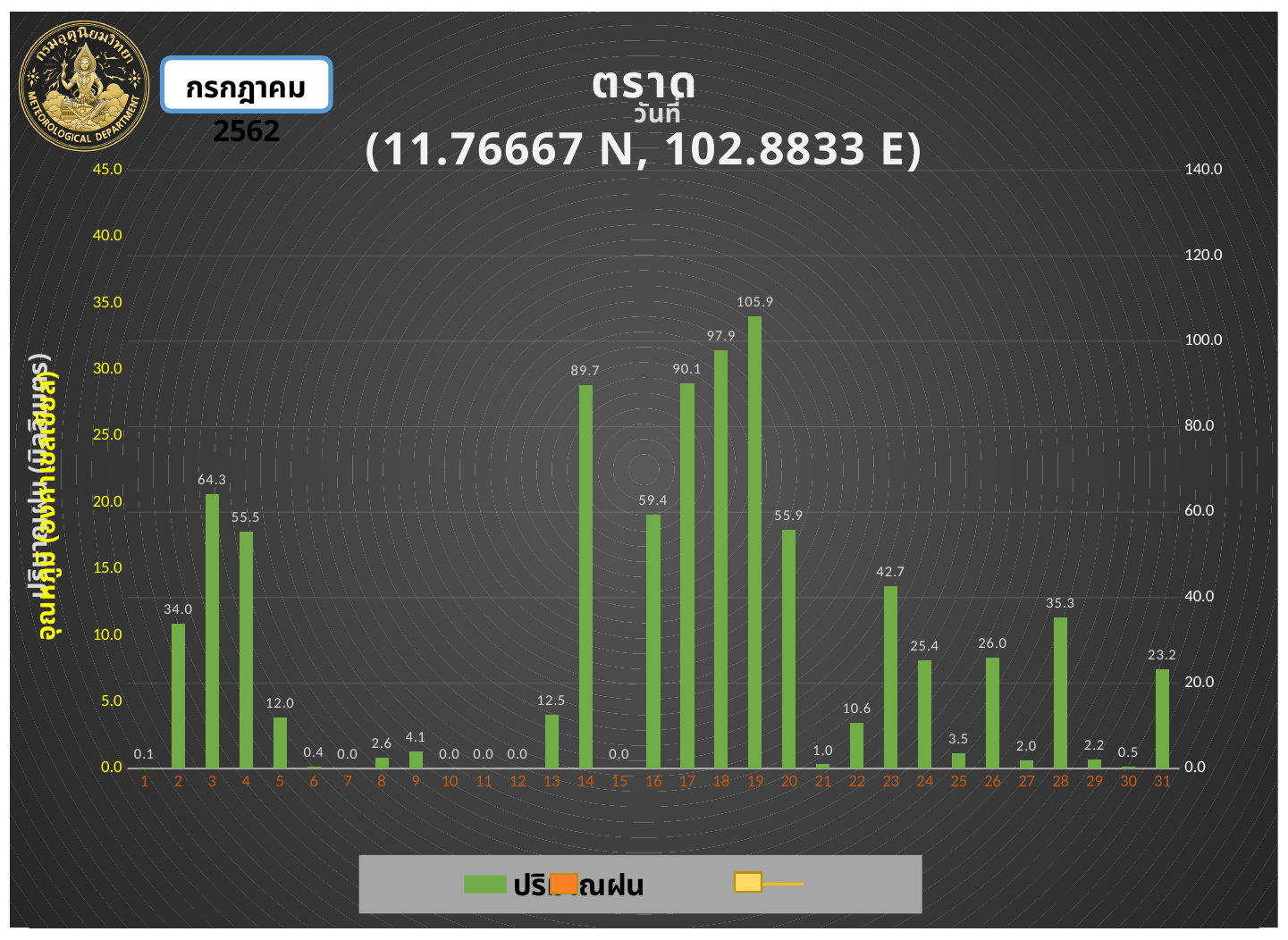
Which is larger, the value for day 14 or the value for day 16? day 14 How many days are shown along the x axis of the chart? 31 What type of chart is shown on the slide? bar chart What is the value labelled on the bar for day 3? 64.3 What is the value shown for day 23? 42.7 Which day has the highest bar in the chart? 19 What is the rainfall value shown for day 19? 105.9 Which is larger, the value for day 28 or the value for day 24? day 28 What is the value shown for day 31? 23.2 What is the name of the station given in the chart title? ตราด What is the difference between the values for day 3 and day 2? 30.3 What is the difference between the values for day 18 and day 17? 7.8